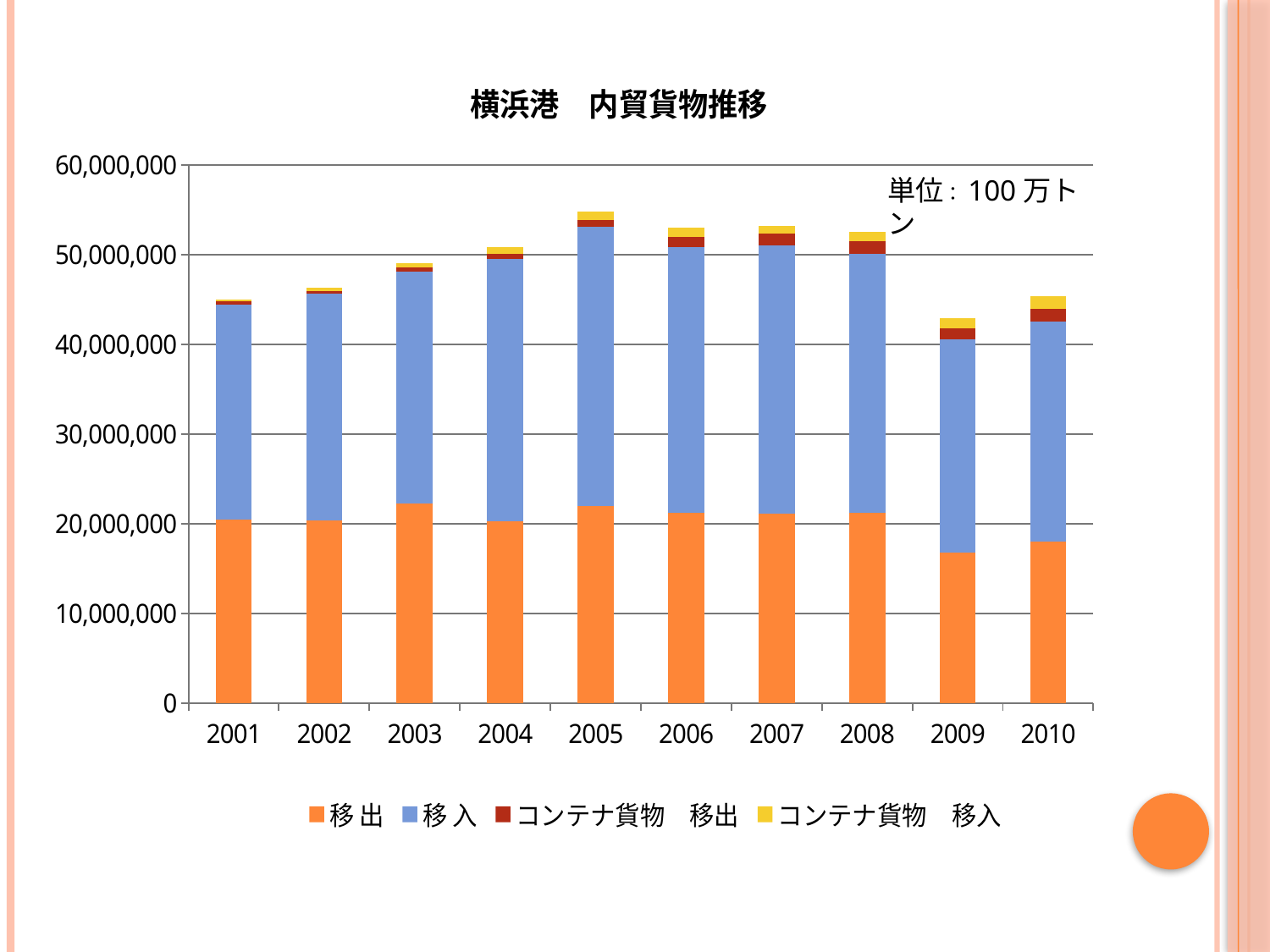
How many series does the legend list? 4 Which year has the tallest stacked bar? 2005 Do the total stacked bars rise or fall from 2005 to 2009? fall Which series is shown in orange in the legend? 移出 Is the 移出 value for 2009 greater or less than 20,000,000? less Is the total stacked bar for 2009 greater or less than 50,000,000? less How many years are shown on the x axis of the chart? 10 Which year has the shortest stacked bar? 2009 Which year has the larger total stacked bar, 2005 or 2009? 2005 Is the total stacked bar for 2005 greater or less than 50,000,000? greater What is the title of the chart? 横浜港 内貿貨物推移 What kind of chart is shown on the slide? stacked bar chart